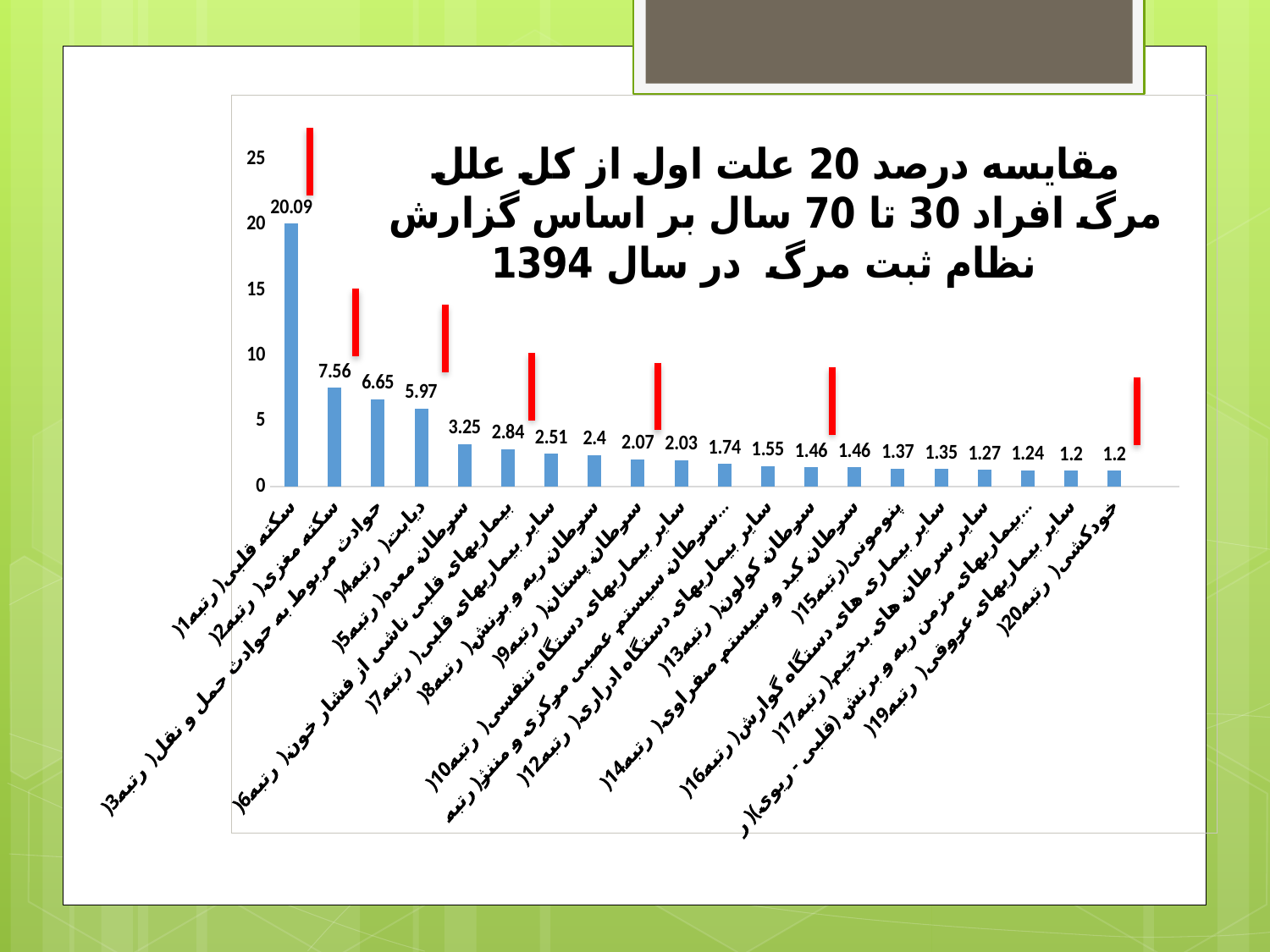
What is the value for سکته قلبی (رتبه 1)? 20.09 What year is mentioned in the chart title? 1394 What is the value for خودکشی (رتبه 20)? 1.2 What is the difference between the values for سکته قلبی (رتبه 1) and سکته مغزی (رتبه 2)? 12.53 Is the value for سکته قلبی (رتبه 1) greater or less than 15? greater Which is larger, the value for سرطان معده (رتبه 5) or the value for سرطان پستان (رتبه 9)? سرطان معده (رتبه 5) Which category has the highest value in the chart? سکته قلبی (رتبه 1) What kind of chart is shown on the slide? bar chart How many categories (causes of death) are plotted in the chart? 20 Do the values rise or fall moving from left to right along the x axis? fall What is the value for دیابت (رتبه 4)? 5.97 What is the value for سکته مغزی (رتبه 2)? 7.56